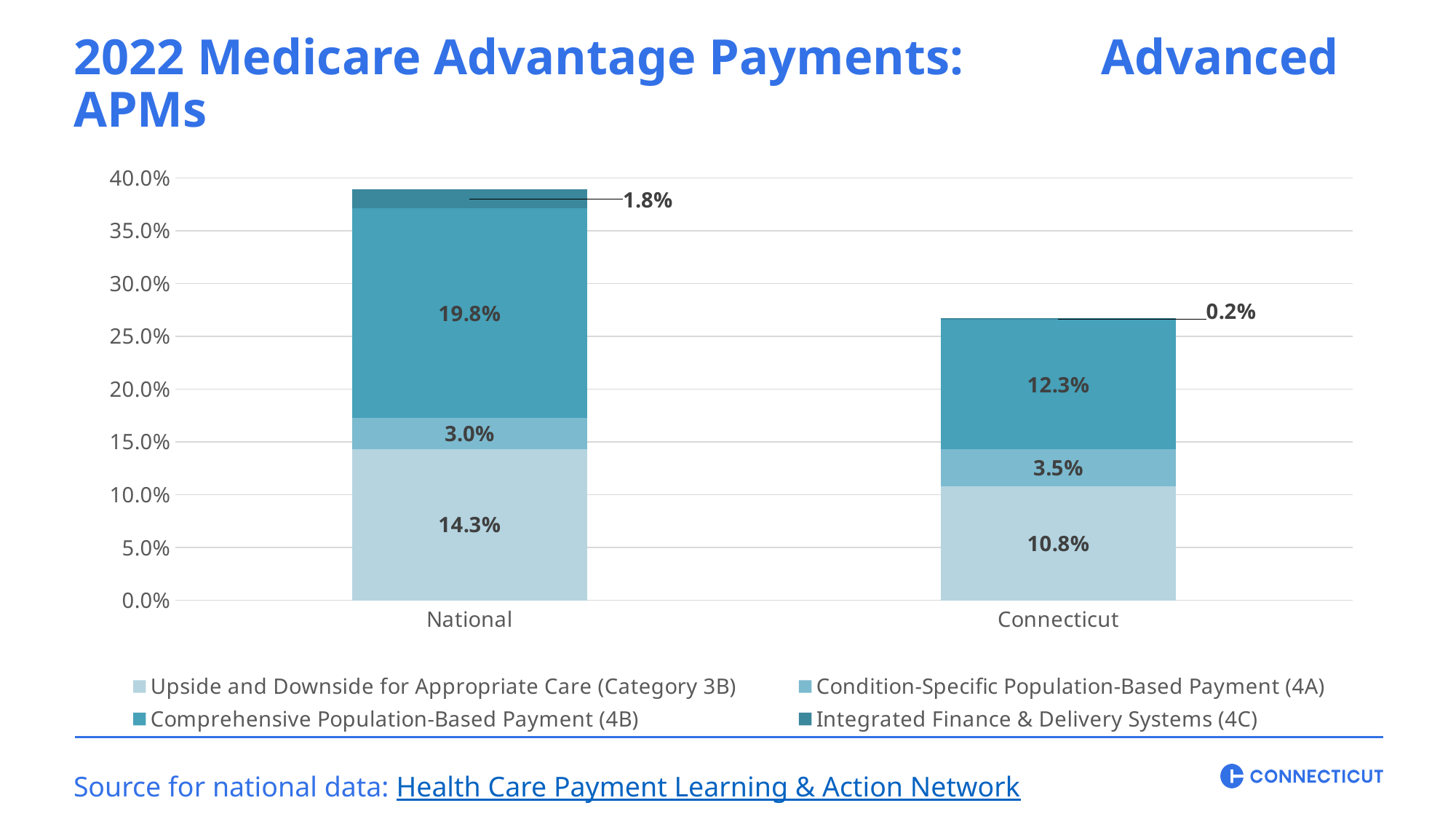
What is the total of the stacked bar for National? 38.9% What is the value for Integrated Finance & Delivery Systems (4C) in the National bar? 1.8% What is the value for Comprehensive Population-Based Payment (4B) in the Connecticut bar? 12.3% What is the value for Condition-Specific Population-Based Payment (4A) in the Connecticut bar? 3.5% Which is larger for Condition-Specific Population-Based Payment (4A): National or Connecticut? Connecticut How many series does the legend list? 4 What kind of chart is shown on the slide? Stacked bar chart How many categories are shown on the x axis? 2 Which category has the higher total stacked bar? National What is the value for Upside and Downside for Appropriate Care (Category 3B) in the National bar? 14.3% What is the total of the stacked bar for Connecticut? 26.8% What is the difference between the Comprehensive Population-Based Payment (4B) values for National and Connecticut? 7.5%